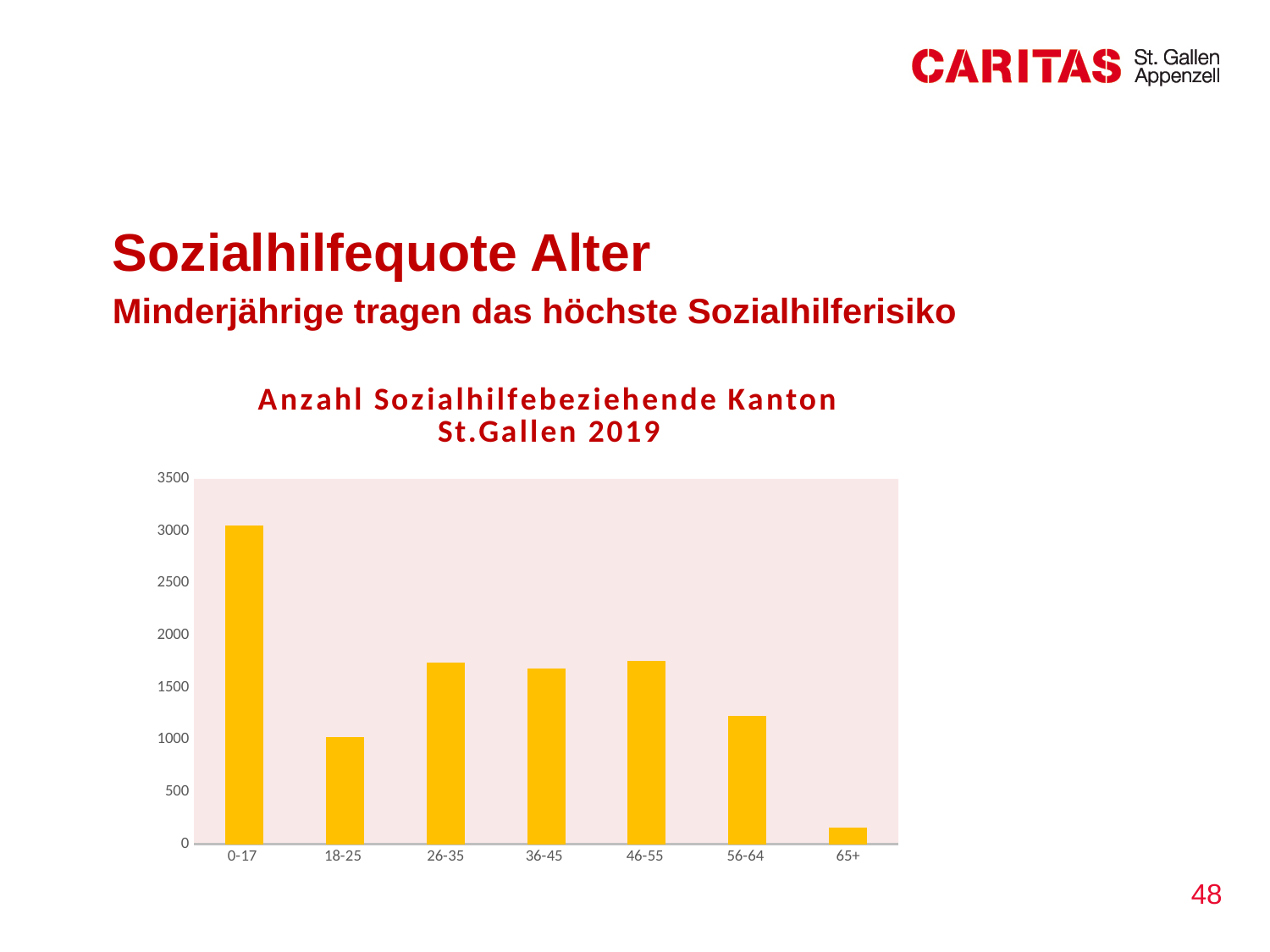
Which age group has the highest number of Sozialhilfebeziehende? 0-17 What kind of chart is shown on the slide? bar chart What is the title of the chart? Anzahl Sozialhilfebeziehende Kanton St.Gallen 2019 Is the value for 56-64 greater or less than 1500? less Is the value for 18-25 greater or less than 1500? less Which has a higher value, 0-17 or 18-25? 0-17 Is the value for 0-17 greater or less than 2500? greater Which has a higher value, 56-64 or 65+? 56-64 How many age categories are shown on the x axis? 7 Which age group has the lowest number of Sozialhilfebeziehende? 65+